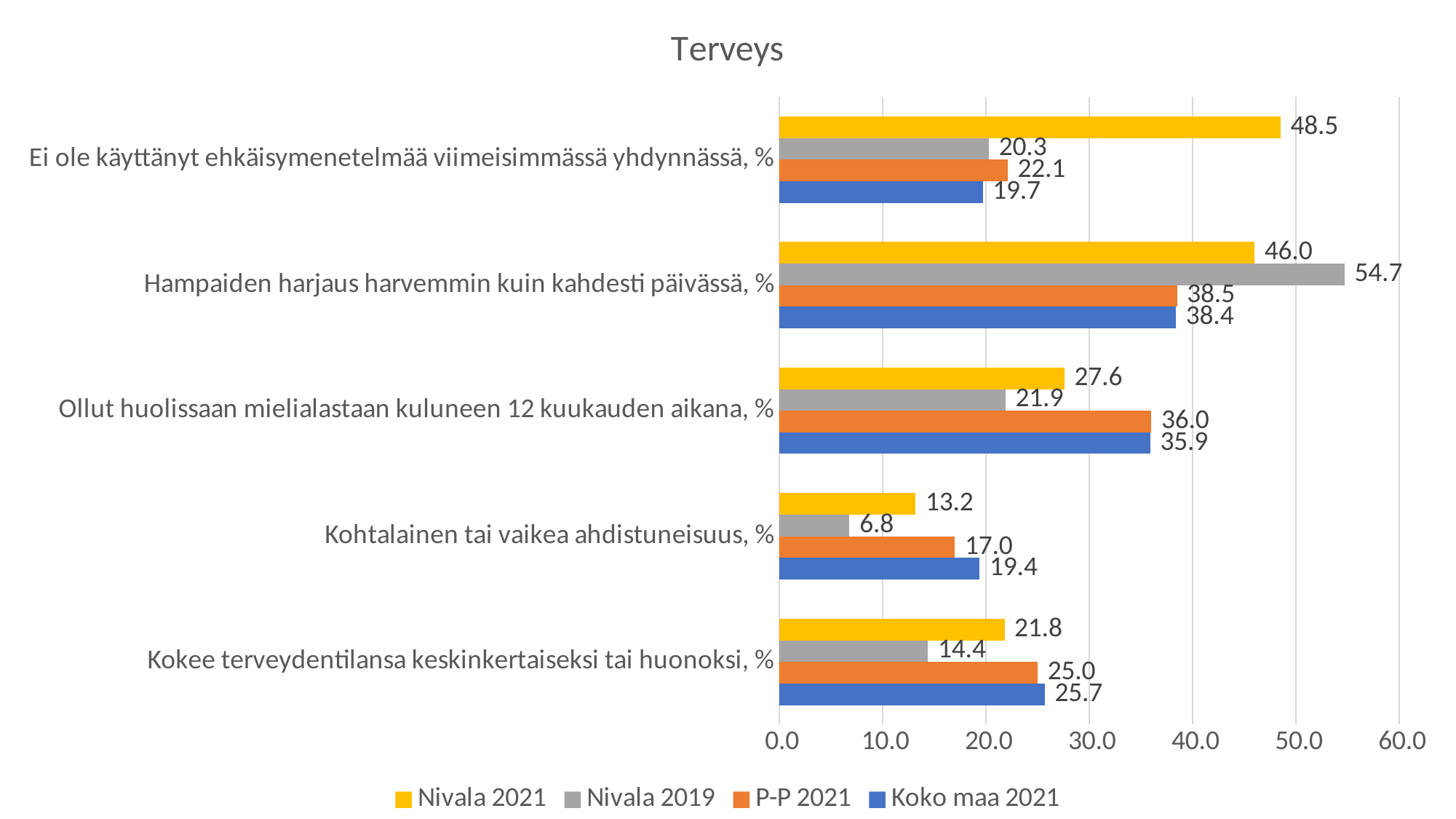
What is the value for Koko maa 2021 in the category "Kohtalainen tai vaikea ahdistuneisuus, %"? 19.4 What is the title of the chart? Terveys How many categories are shown on the chart? 5 What is the difference between the Nivala 2021 and Nivala 2019 values in the category "Ei ole käyttänyt ehkäisymenetelmää viimeisimmässä yhdynnässä, %"? 28.2 In the category "Ollut huolissaan mielialastaan kuluneen 12 kuukauden aikana, %", which is larger: Nivala 2021 or P-P 2021? P-P 2021 What is the value for Nivala 2019 in the category "Hampaiden harjaus harvemmin kuin kahdesti päivässä, %"? 54.7 What kind of chart is shown on the slide? Bar chart What is the value for P-P 2021 in the category "Kokee terveydentilansa keskinkertaiseksi tai huonoksi, %"? 25.0 What is the value for Nivala 2021 in the category "Ei ole käyttänyt ehkäisymenetelmää viimeisimmässä yhdynnässä, %"? 48.5 How many series does the legend list? 4 Which category has the lowest value for Nivala 2019? Kohtalainen tai vaikea ahdistuneisuus, % Which category has the highest value for Nivala 2021? Ei ole käyttänyt ehkäisymenetelmää viimeisimmässä yhdynnässä, %